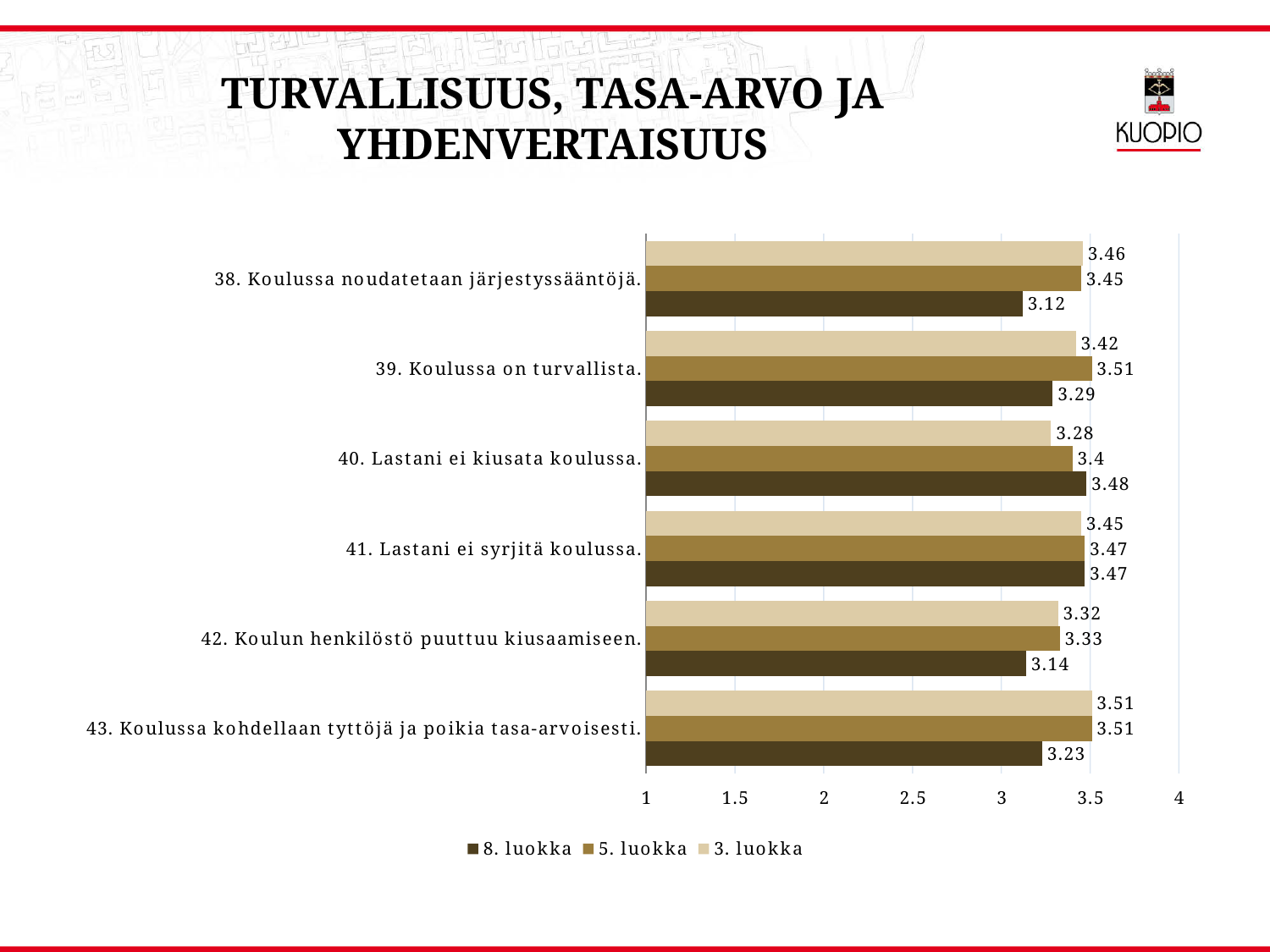
What is the value for 3. luokka for "40. Lastani ei kiusata koulussa."? 3.28 Which category has the highest value for 8. luokka? 40. Lastani ei kiusata koulussa. How many categories (statements) are shown on the chart? 6 Which category has the lowest value for 8. luokka? 38. Koulussa noudatetaan järjestyssääntöjä. What is the value for 8. luokka for "38. Koulussa noudatetaan järjestyssääntöjä."? 3.12 For "40. Lastani ei kiusata koulussa.", which is larger: the value for 8. luokka or for 3. luokka? 8. luokka How many series does the legend list? 3 What is the value for 5. luokka for "39. Koulussa on turvallista."? 3.51 What is the difference between the 3. luokka and 8. luokka values for "43. Koulussa kohdellaan tyttöjä ja poikia tasa-arvoisesti."? 0.28 Which series is shown with the darkest brown bars in the legend? 8. luokka What is the value for 8. luokka for "42. Koulun henkilöstö puuttuu kiusaamiseen."? 3.14 What type of chart is shown on the slide? bar chart